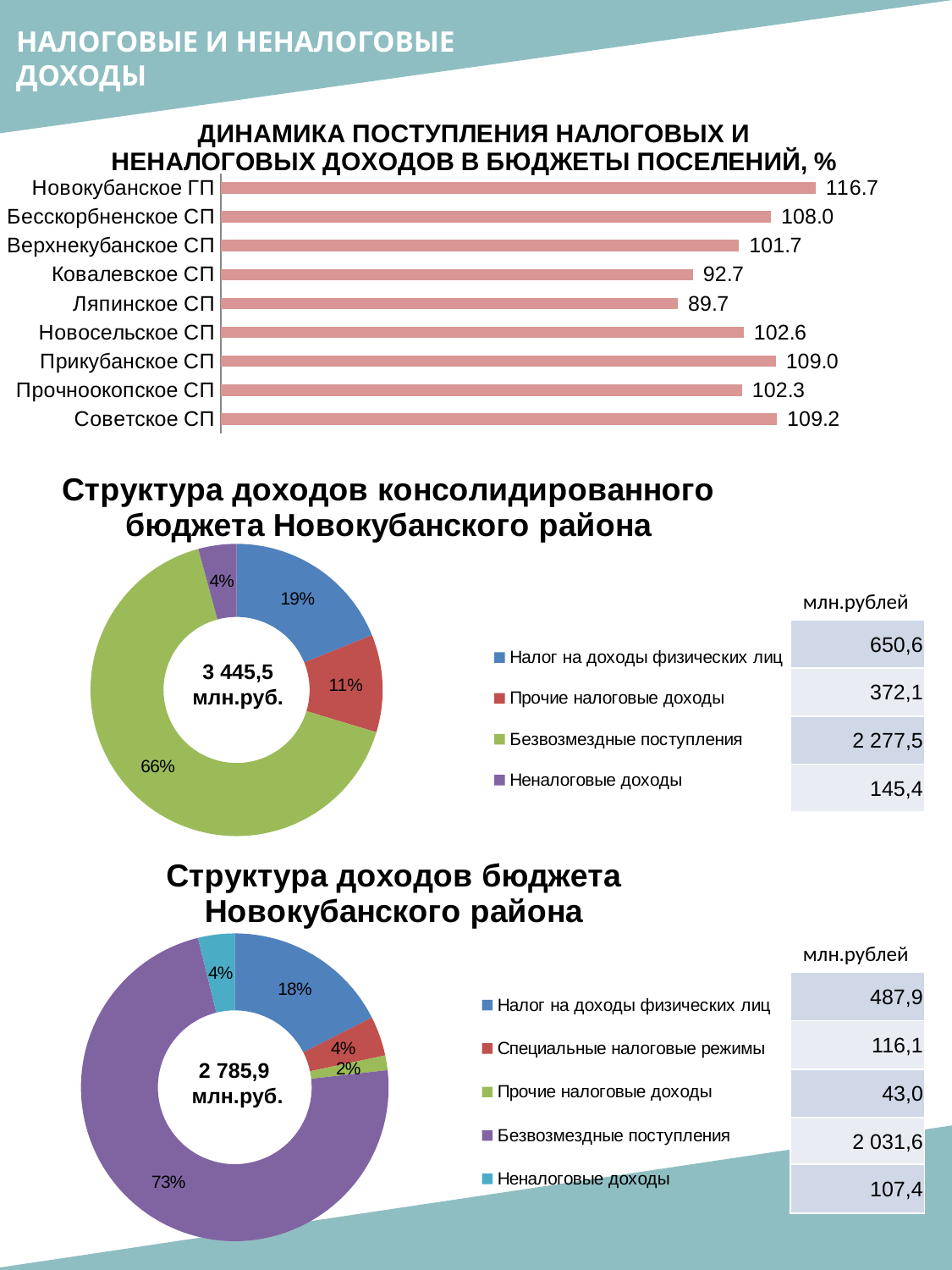
In the bar chart 'Динамика поступления налоговых и неналоговых доходов в бюджеты поселений, %', what is the difference between the values for Новокубанское ГП and Ляпинское СП? 27.0 In the chart 'Структура доходов консолидированного бюджета Новокубанского района', what share does Безвозмездные поступления have? 66% In the bar chart 'Динамика поступления налоговых и неналоговых доходов в бюджеты поселений, %', which settlement has the highest value? Новокубанское ГП In the bar chart 'Динамика поступления налоговых и неналоговых доходов в бюджеты поселений, %', what is the value for Новокубанское ГП? 116.7 In the bar chart 'Динамика поступления налоговых и неналоговых доходов в бюджеты поселений, %', what is the value for Ляпинское СП? 89.7 What type of chart is 'Динамика поступления налоговых и неналоговых доходов в бюджеты поселений, %'? bar chart How many settlements are shown in the bar chart 'Динамика поступления налоговых и неналоговых доходов в бюджеты поселений, %'? 9 In the bar chart 'Динамика поступления налоговых и неналоговых доходов в бюджеты поселений, %', which settlement has the lowest value? Ляпинское СП How many entries does the legend list for the chart 'Структура доходов бюджета Новокубанского района'? 5 In the chart 'Структура доходов консолидированного бюджета Новокубанского района', what total is shown in the centre of the doughnut? 3 445,5 млн.руб. In the chart 'Структура доходов бюджета Новокубанского района', what share does Налог на доходы физических лиц have? 18% In the bar chart 'Динамика поступления налоговых и неналоговых доходов в бюджеты поселений, %', which is larger: Бесскорбненское СП or Ковалевское СП? Бесскорбненское СП